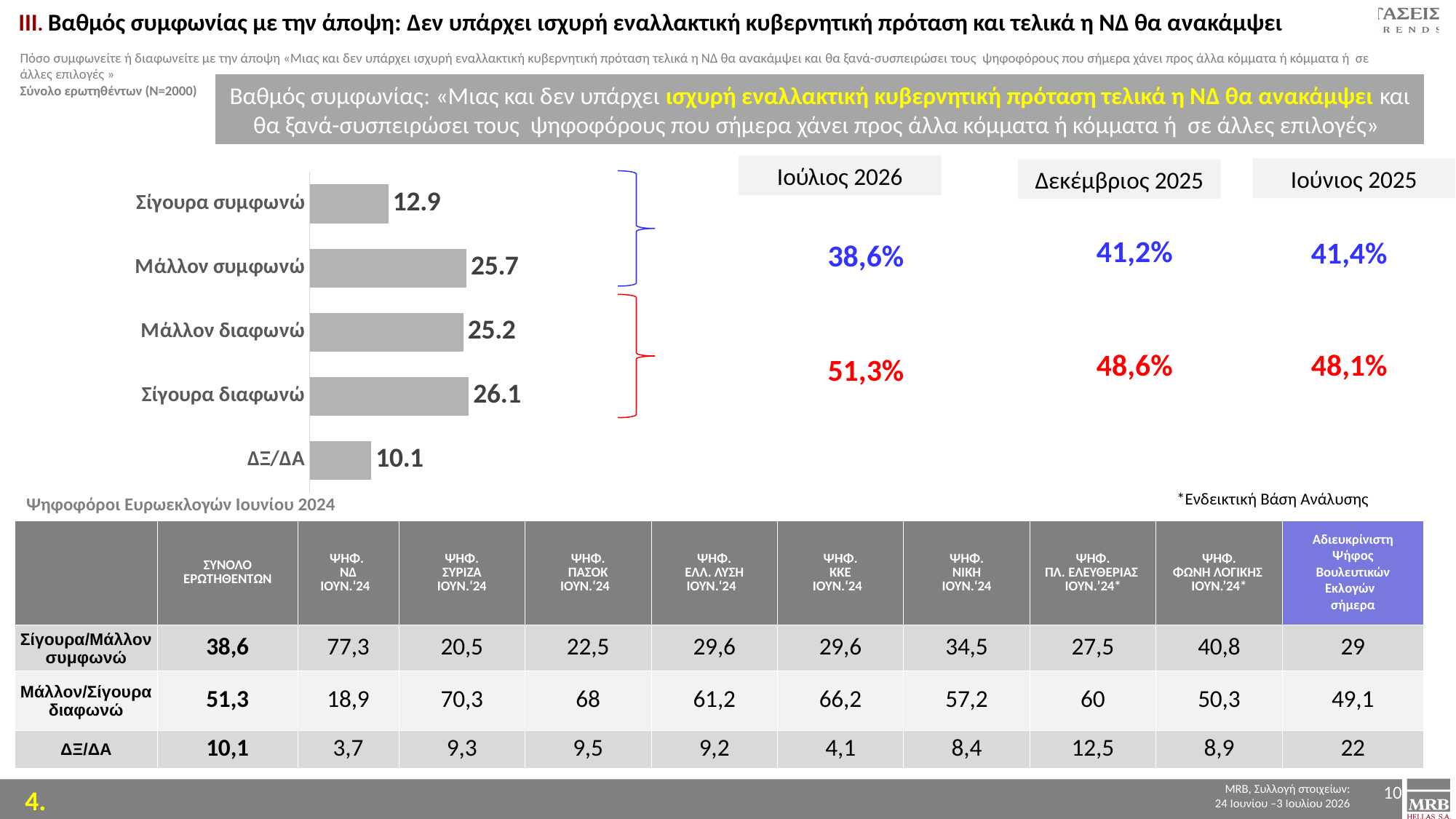
Which category has the highest value in the bar chart? Σίγουρα διαφωνώ What is the value for ΔΞ/ΔΑ in the bar chart? 10.1 What is the value for Σίγουρα συμφωνώ in the bar chart? 12.9 What is the combined total of the Σίγουρα συμφωνώ and Μάλλον συμφωνώ bars in the bar chart? 38.6 What is the value for Μάλλον συμφωνώ in the bar chart? 25.7 What is the value for Σίγουρα διαφωνώ in the bar chart? 26.1 What kind of chart is used to show the degree of agreement? Bar chart What is the difference between the values for Μάλλον συμφωνώ and Σίγουρα συμφωνώ in the bar chart? 12.8 Which is larger in the bar chart: the value for Σίγουρα συμφωνώ or the value for ΔΞ/ΔΑ? Σίγουρα συμφωνώ How many categories are shown in the bar chart? 5 Which category has the lowest value in the bar chart? ΔΞ/ΔΑ What is the value for Μάλλον διαφωνώ in the bar chart? 25.2